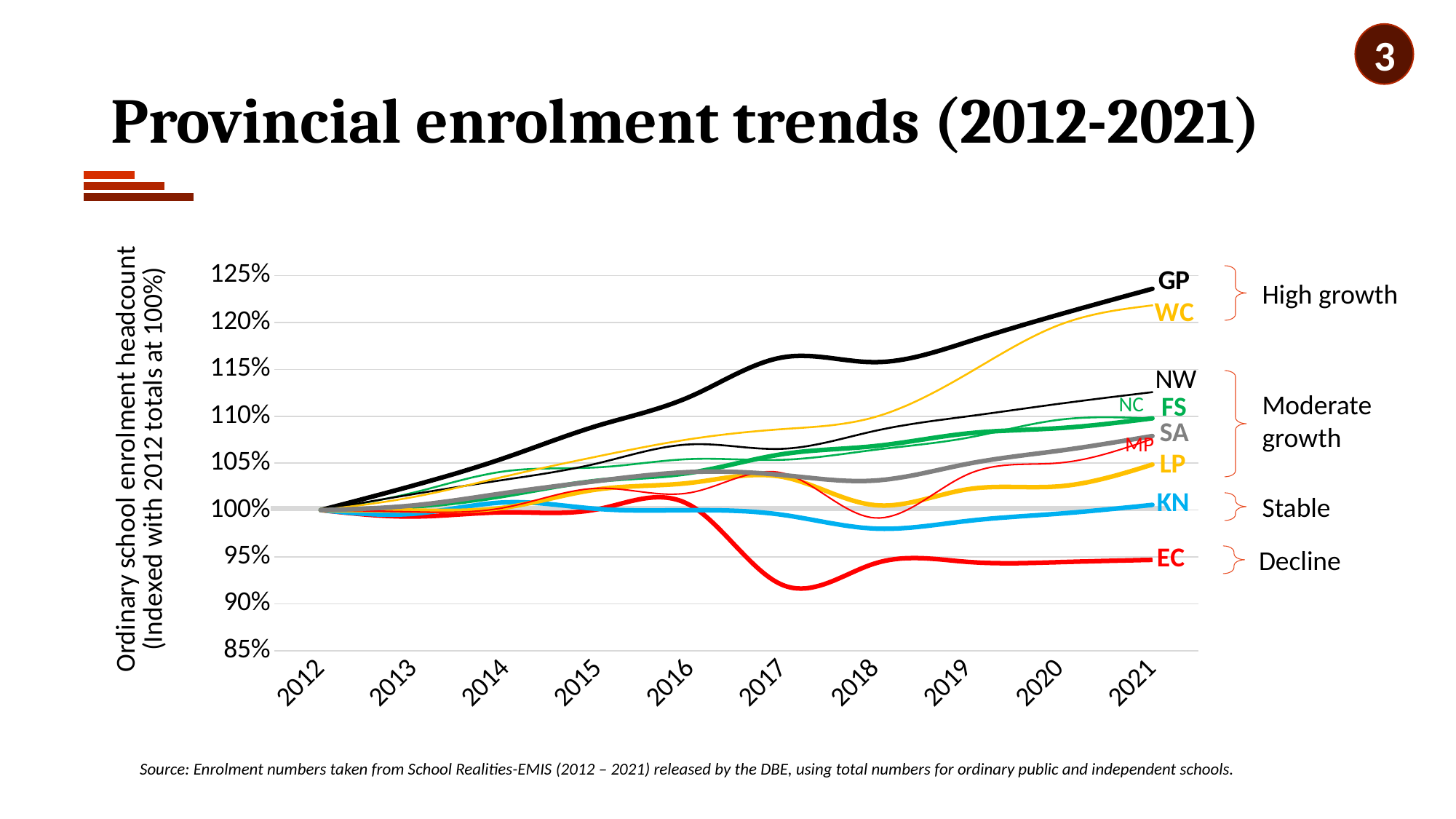
Is the value for GP in 2021 greater or less than 120%? greater Which province has the lowest indexed enrolment in 2021? EC Is the value for KN in 2018 greater or less than 100%? less How many provinces are plotted as lines on the chart? 10 What kind of chart is shown on the slide? Line chart What is the title of the chart on the slide? Provincial enrolment trends (2012-2021) Which province has the highest indexed enrolment in 2021? GP In 2021, which is larger: the value for WC or the value for KN? WC How many years are shown along the x axis of the chart? 10 Is the value for EC in 2021 greater or less than 100%? less Does the GP line rise or fall from 2012 to 2021? Rise